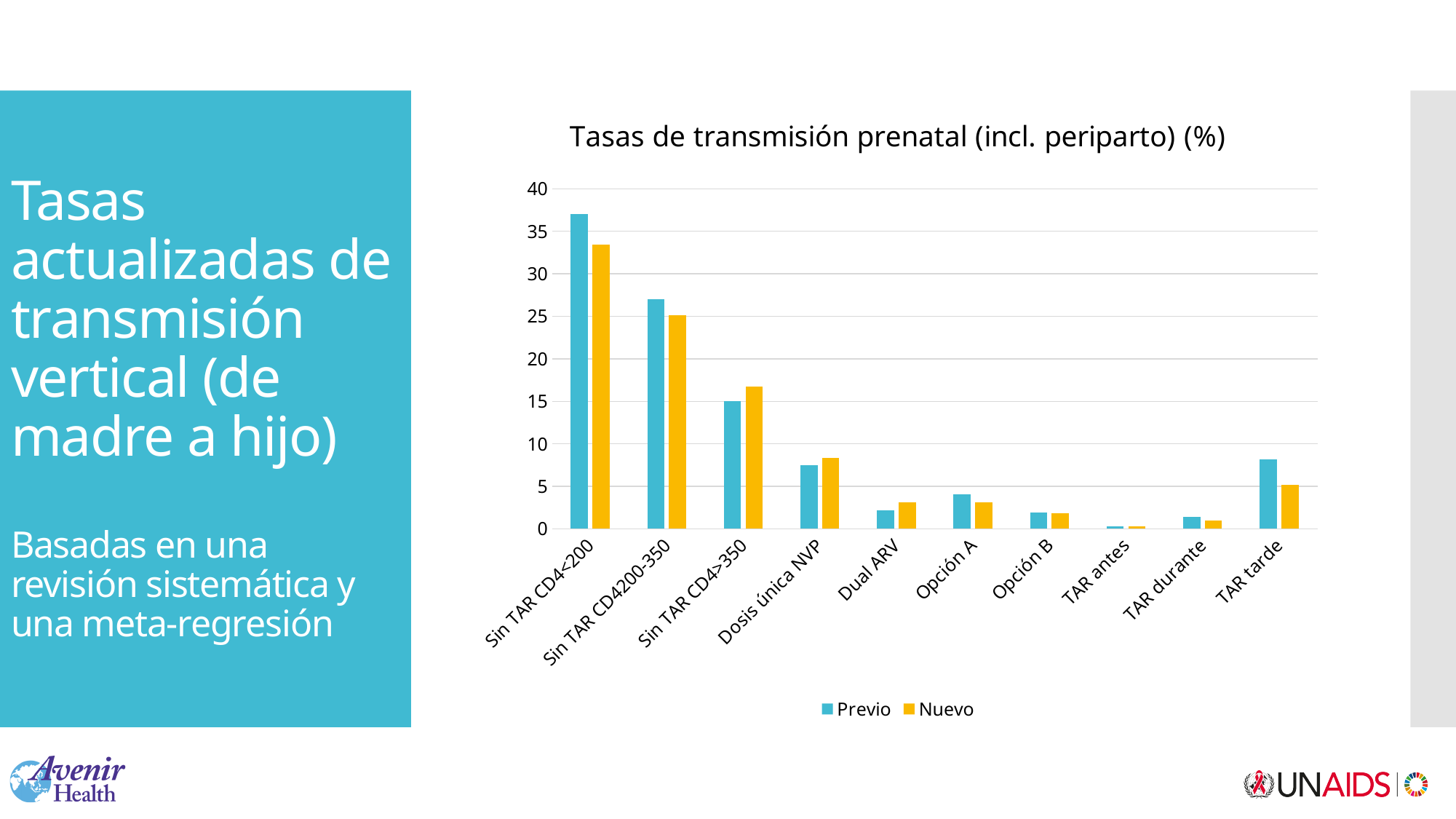
Which category has the lowest Previo value? TAR antes For TAR tarde, which is larger, the Previo or the Nuevo value? Previo How many categories are shown on the x axis of the chart? 10 Is the Nuevo value for Sin TAR CD4200-350 greater or less than 30? less Which category has the highest Previo value? Sin TAR CD4<200 What kind of chart is shown on the slide? Bar chart Is the Previo value for TAR tarde greater or less than 5? greater How many series does the legend list? 2 For Sin TAR CD4>350, which is larger, the Previo or the Nuevo value? Nuevo Which category has the highest Nuevo value? Sin TAR CD4<200 What is the title of the chart? Tasas de transmisión prenatal (incl. periparto) (%) Is the Previo value for Sin TAR CD4<200 greater or less than 35? greater